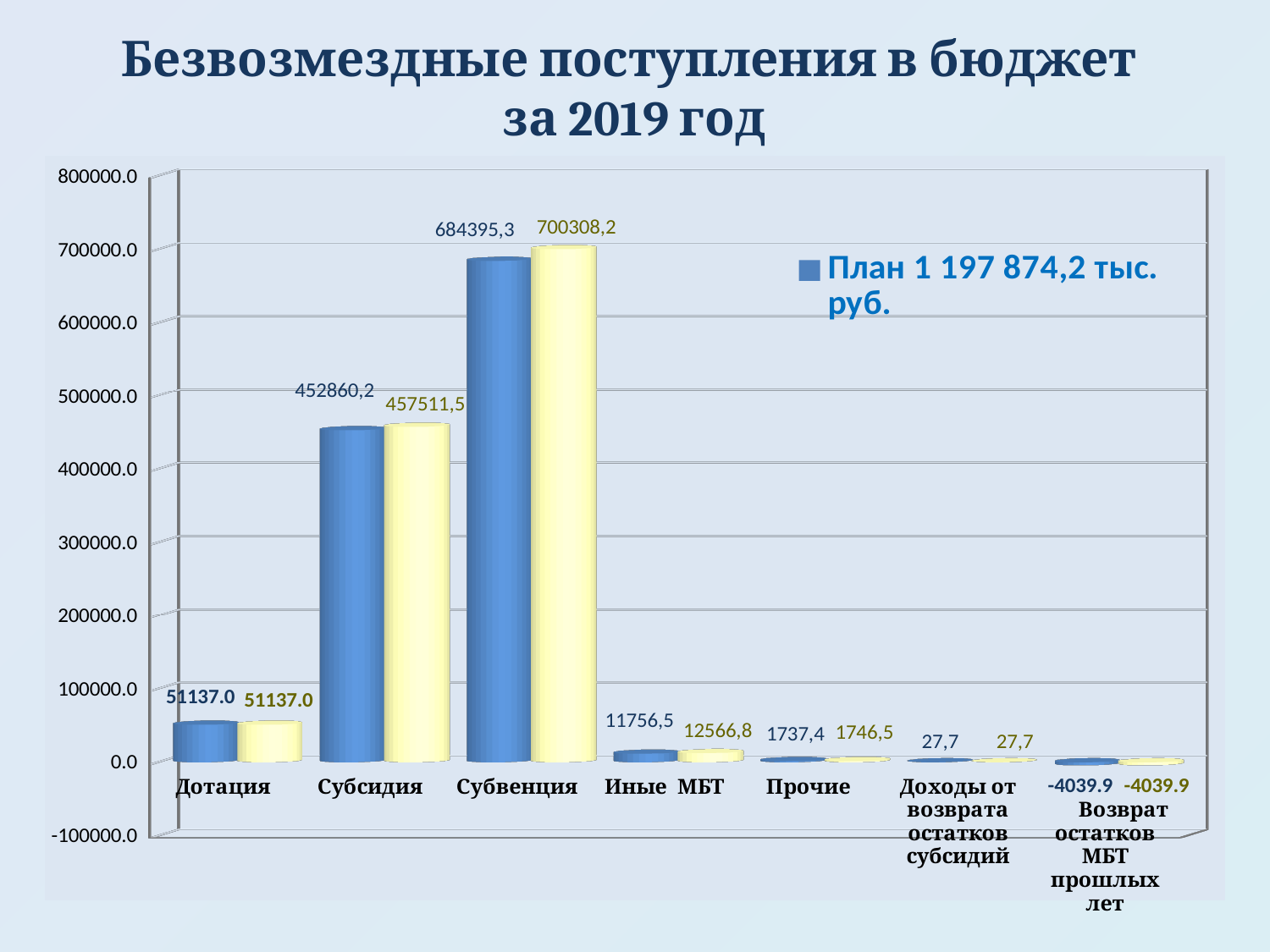
What is the value shown for Возврат остатков МБТ прошлых лет? -4039.9 What is the value of the blue (План) bar for Иные МБТ? 11756,5 What is the difference between the yellow bar and the blue (План) bar for Субвенция? 15912,9 Which category has the highest blue (План) bar? Субвенция How many series does the chart legend list? 1 How many categories are shown on the x axis of the chart? 7 What is the legend entry shown on the chart? План 1 197 874,2 тыс. руб. Which category has the lowest value in the chart? Возврат остатков МБТ прошлых лет What is the value of the blue (План) bar for Субвенция? 684395,3 What type of chart is shown on the slide? Bar chart Which is larger for Иные МБТ: the blue (План) bar or the yellow bar? The yellow bar What is the value of the yellow bar for Субсидия? 457511,5